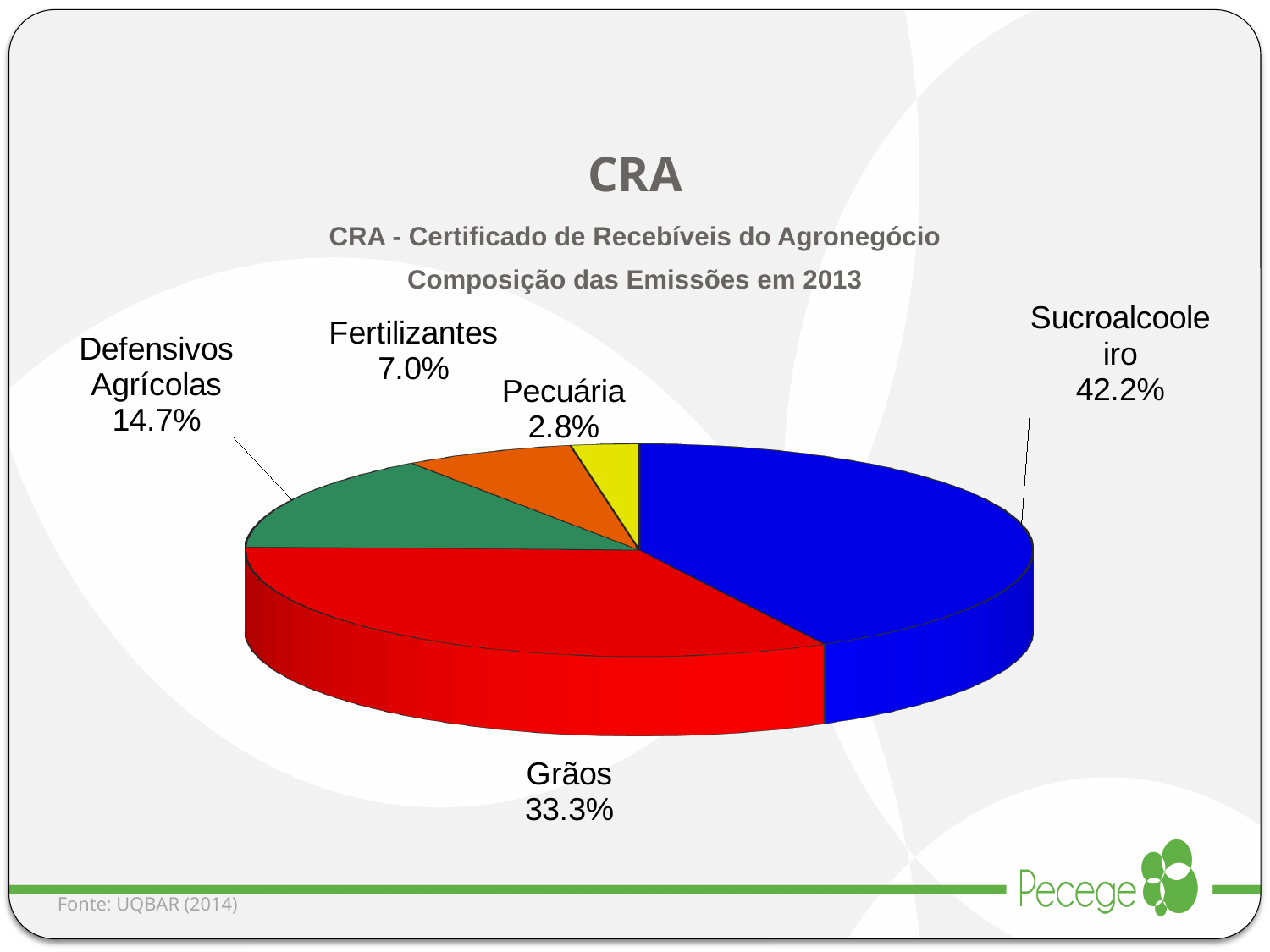
What colour is the Grãos slice? Red Which category has the smallest share of the pie? Pecuária What is the difference in percentage points between Sucroalcooleiro and Grãos? 8.9 What is the value shown for Fertilizantes? 7.0% Which is larger, the share for Defensivos Agrícolas or the share for Fertilizantes? Defensivos Agrícolas Which category has the largest share of the pie? Sucroalcooleiro What is the value shown for Defensivos Agrícolas? 14.7% What share of the pie does Sucroalcooleiro represent? 42.2% What is the value shown for Pecuária? 2.8% How many categories are shown in the pie chart? 5 What kind of chart is shown on the slide? Pie chart What is the value shown for Grãos? 33.3%